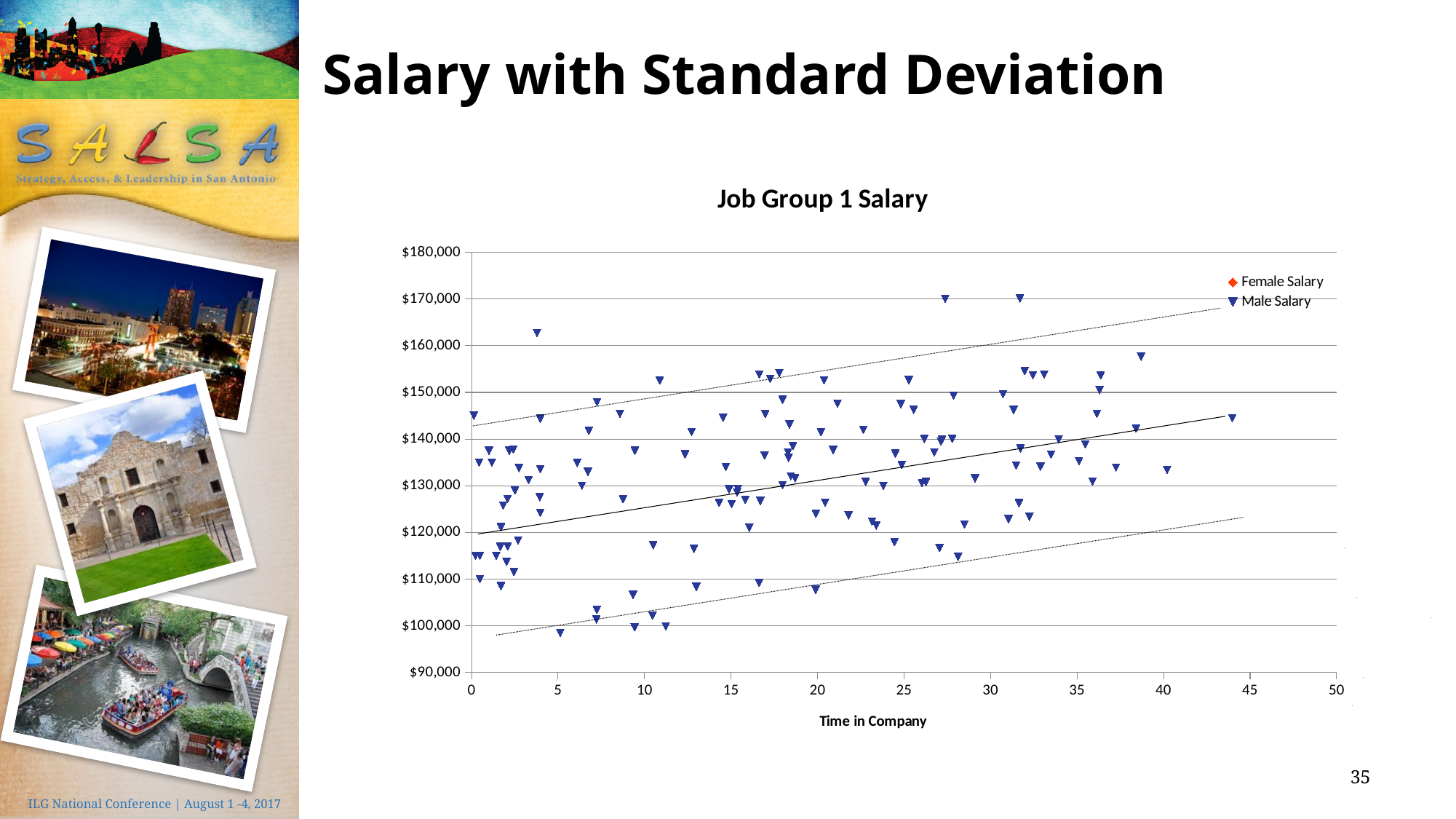
Is the lowest plotted Male Salary point greater or less than $110,000? less How many series does the chart legend list? 2 What kind of chart is shown on the slide? Scatter chart Is the highest plotted Male Salary point greater or less than $160,000? greater What is the label of the horizontal axis? Time in Company Is the Male Salary point plotted at about 4 years in company, the highest point in that region, greater or less than $160,000? greater What is the highest value shown on the vertical axis? $180,000 What is the largest value shown on the horizontal axis? 50 Does the central trend line for salary rise or fall as time in company increases? Rises